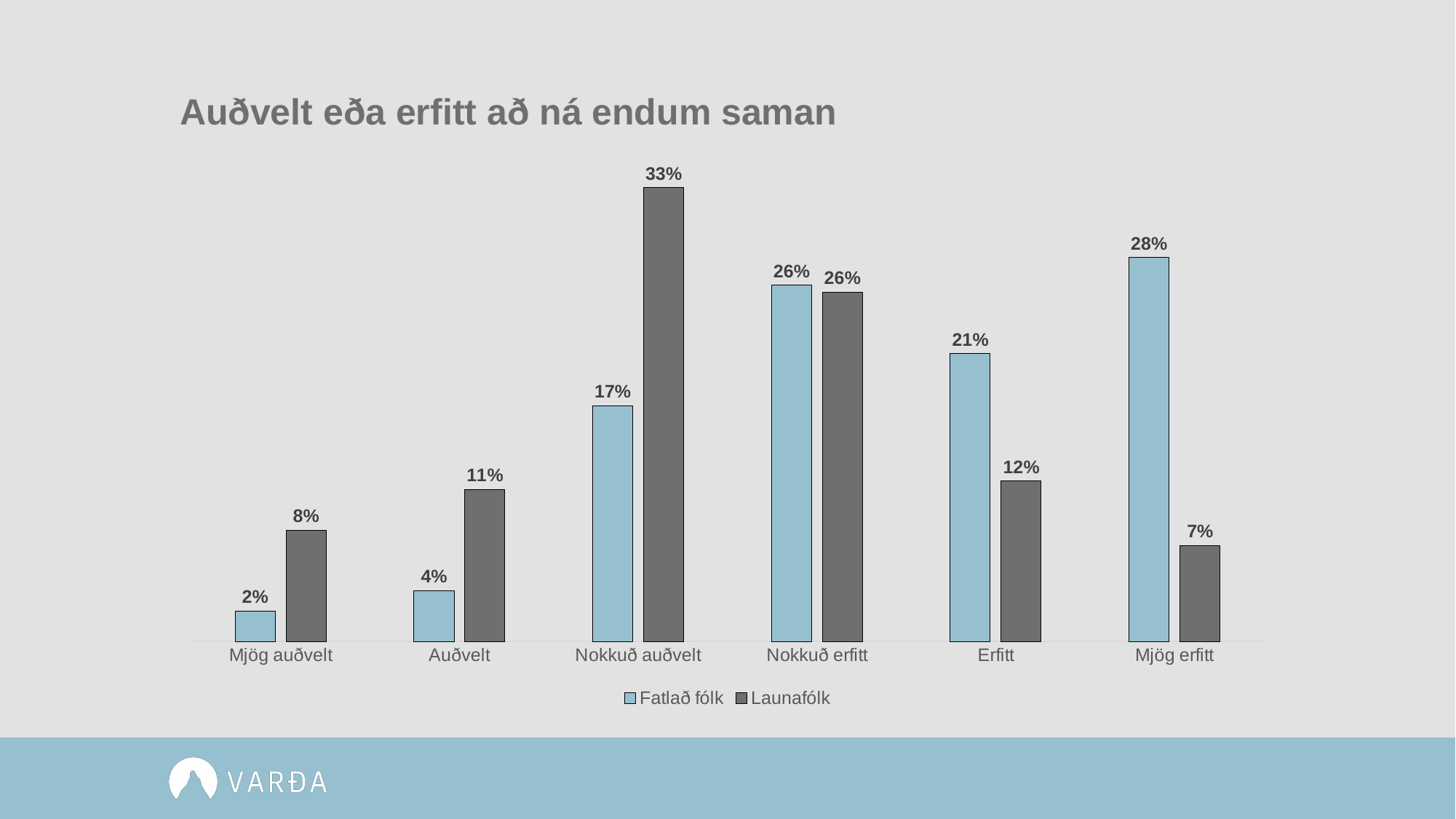
What kind of chart is shown on the slide? Bar chart Which series is shown in light blue? Fatlað fólk Which series has the larger value in the Auðvelt category, Fatlað fólk or Launafólk? Launafólk What is the value for Fatlað fólk in the Mjög erfitt category? 28% How many categories are shown on the x axis? 6 What is the value for Launafólk in the Nokkuð auðvelt category? 33% Which category has the highest value for Launafólk? Nokkuð auðvelt What is the value for Fatlað fólk in the Mjög auðvelt category? 2% Which category has the lowest value for Fatlað fólk? Mjög auðvelt What is the difference between Fatlað fólk and Launafólk in the Erfitt category? 9% What is the title of the chart? Auðvelt eða erfitt að ná endum saman How many series does the legend list? 2